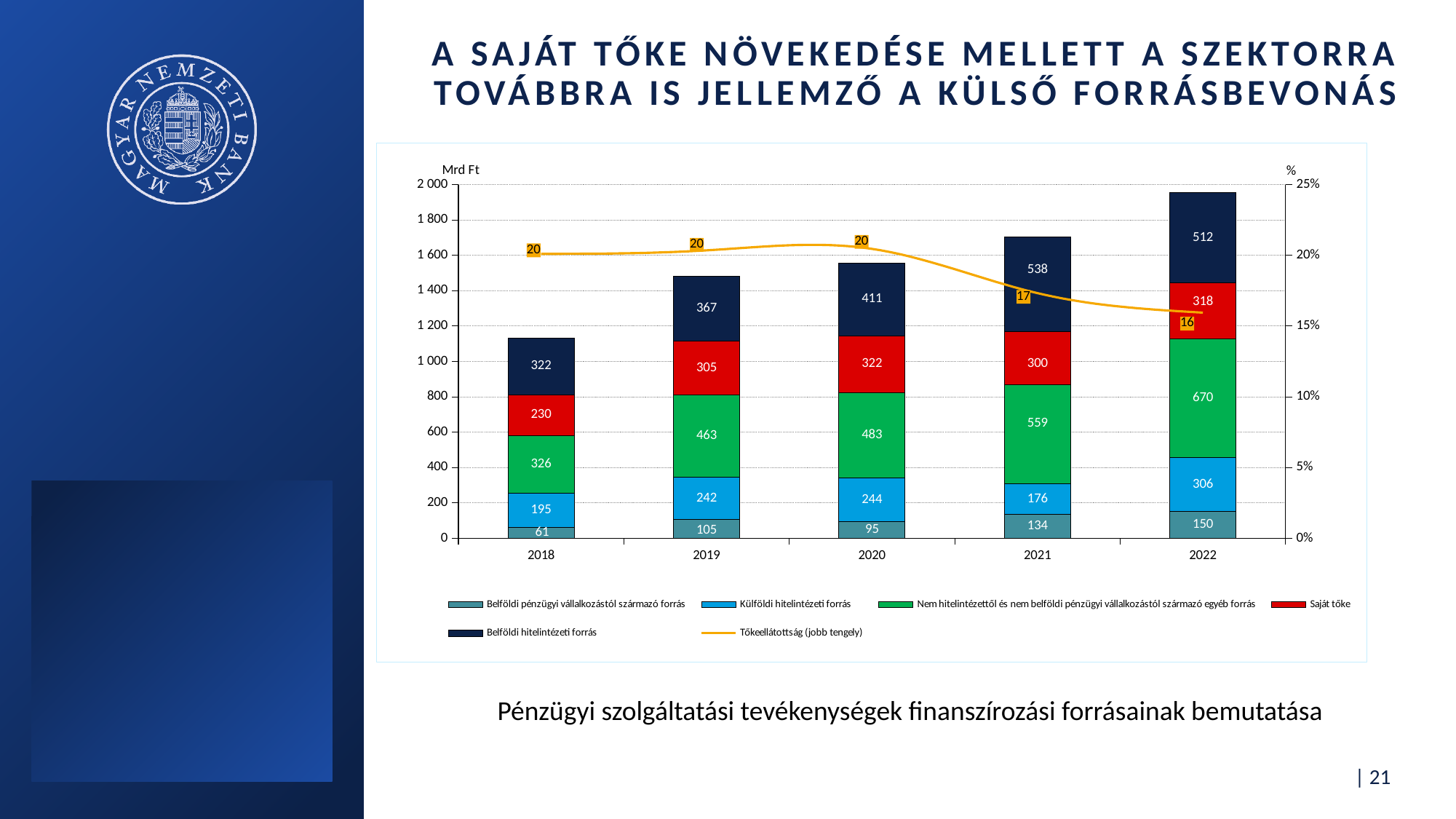
How many years are shown on the x axis? 5 Is the total height of the 2022 stacked bar greater or less than 1 800? greater In which year is the Belföldi pénzügyi vállalkozástól származó forrás segment the smallest? 2018 What is the Tőkeellátottság (jobb tengely) value for 2021? 17 Does the Tőkeellátottság (jobb tengely) line rise or fall from 2020 to 2022? fall What is the difference between the Belföldi hitelintézeti forrás values for 2021 and 2022? 26 How many series does the legend list? 6 What is the value of Saját tőke for 2022? 318 What kind of chart is shown on the slide? Stacked bar chart with a line What is the value of Külföldi hitelintézeti forrás in 2019? 242 In which year is the Nem hitelintézettől és nem belföldi pénzügyi vállalkozástól származó egyéb forrás segment the largest? 2022 Which year has the larger Saját tőke value, 2019 or 2020? 2020